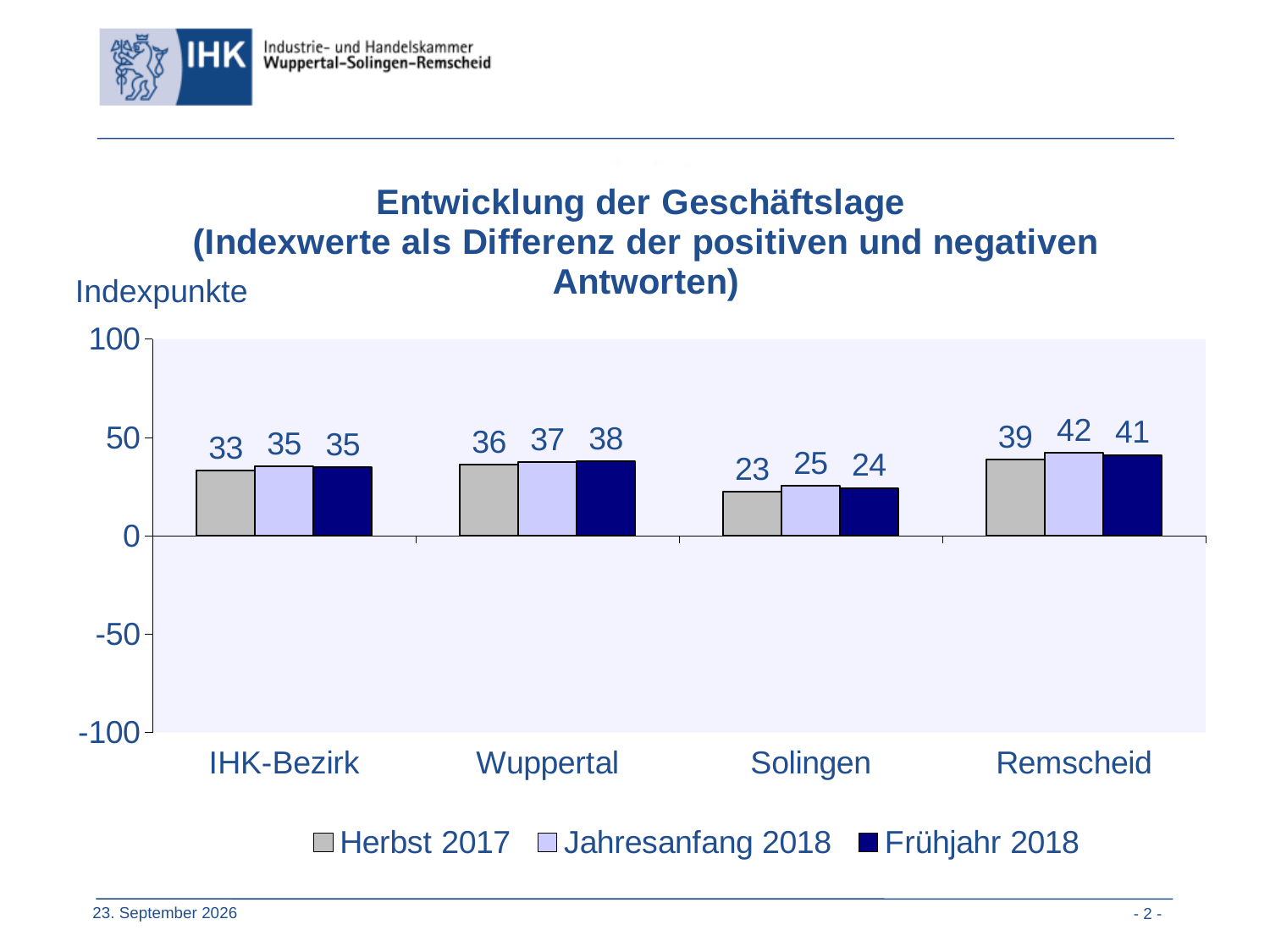
How many series does the legend list? 3 What is the value for Solingen in the Herbst 2017 series? 23 What is the value for Wuppertal in the Frühjahr 2018 series? 38 What is the value for Remscheid in the Jahresanfang 2018 series? 42 What kind of chart is shown on the slide? bar chart How many categories are shown on the x axis? 4 Is the Herbst 2017 value for Remscheid greater or less than 50? less Which is larger: the Jahresanfang 2018 value for Wuppertal or for IHK-Bezirk? Wuppertal Which category has the lowest value in the Herbst 2017 series? Solingen What is the label on the y axis of the chart? Indexpunkte Which category has the highest value in the Frühjahr 2018 series? Remscheid What is the difference between the Frühjahr 2018 values for Remscheid and Solingen? 17